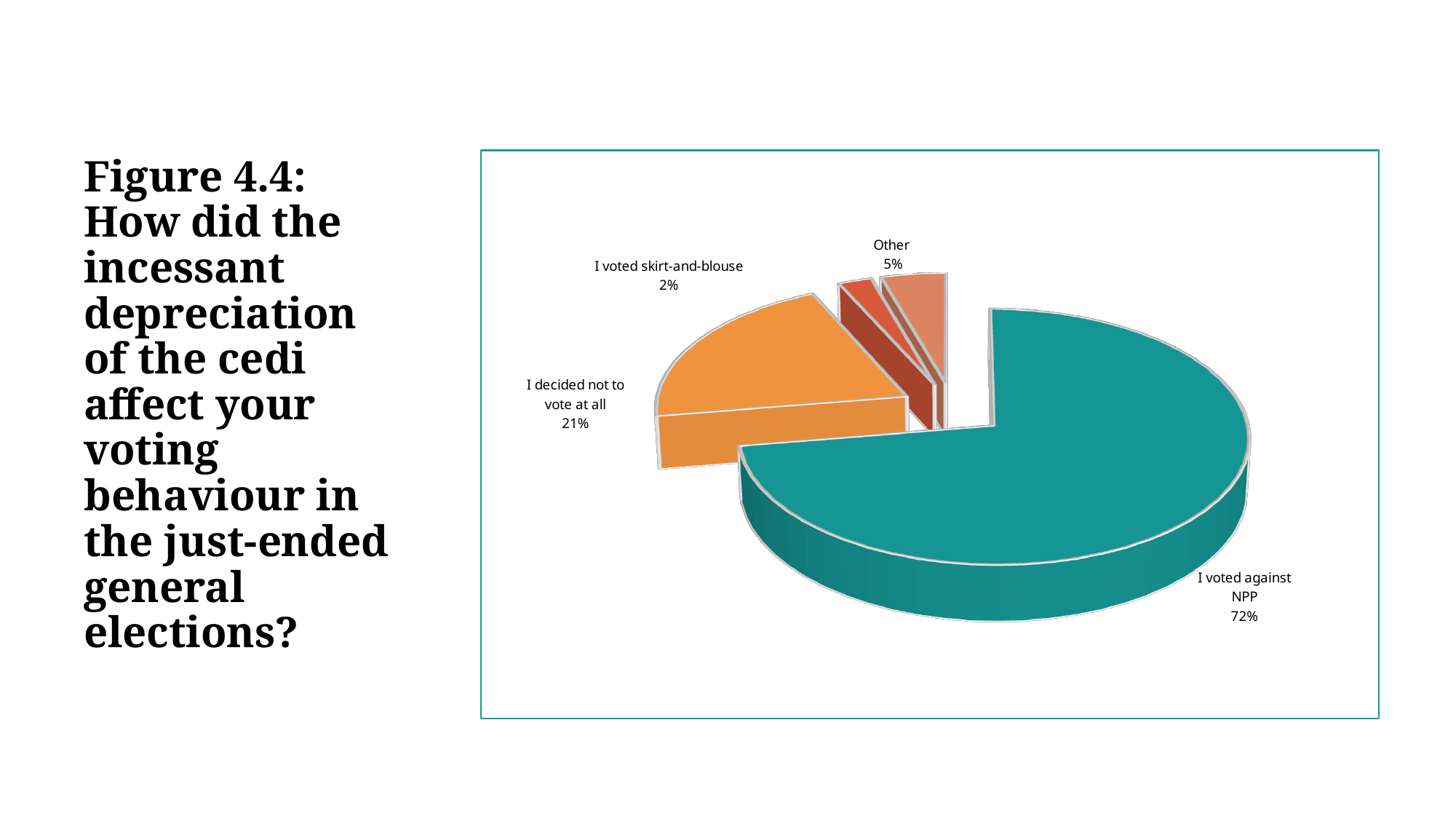
What percentage of respondents decided not to vote at all? 21% What percentage of respondents fall under 'Other'? 5% What percentage of respondents said they voted against NPP? 72% What percentage of respondents said they voted skirt-and-blouse? 2% How many categories are shown in the pie chart? 4 Which is larger: the share for 'Other' or the share for 'I voted skirt-and-blouse'? Other Which response has the largest share of the pie? I voted against NPP What is the difference in percentage points between 'I voted against NPP' and 'I decided not to vote at all'? 51 What colour is the slice for 'I voted against NPP'? Teal What is the combined share of 'I decided not to vote at all' and 'Other'? 26% What kind of chart is shown on the slide? Pie chart Which response has the smallest share of the pie? I voted skirt-and-blouse